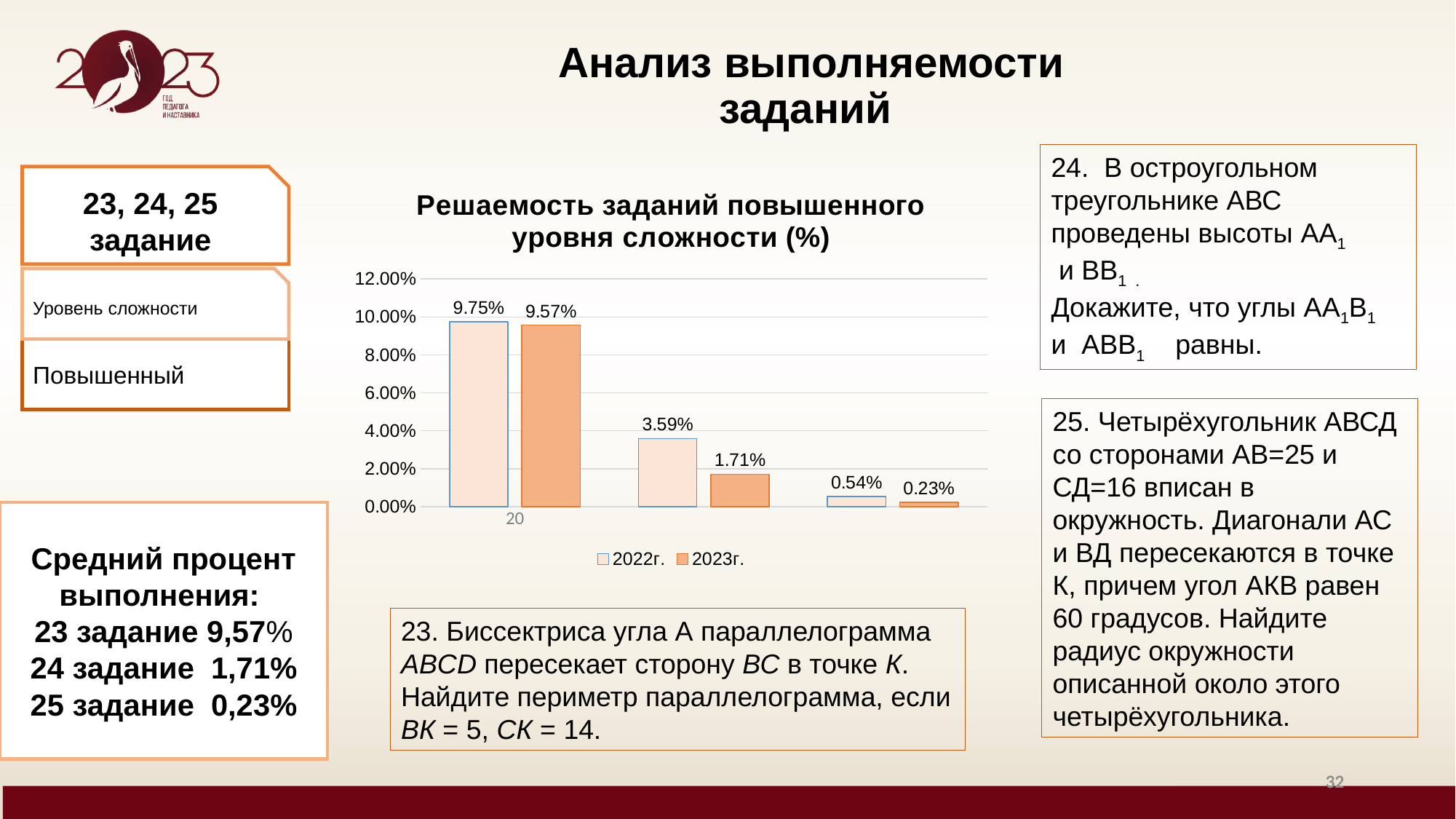
What kind of chart is shown on the slide? bar chart What is the value of the 2023г. bar in the second (middle) group? 1.71% How many groups of bars are plotted in the chart? 3 What is the value of the 2022г. bar in the third (rightmost) group? 0.54% In the middle group, which series has the larger value, 2022г. or 2023г.? 2022г. What is the title of the chart? Решаемость заданий повышенного уровня сложности (%) What is the highest value shown in the chart? 9.75% What are the two series named in the legend? 2022г. and 2023г. How many series does the chart legend list? 2 What is the value of the 2022г. bar in the first (leftmost) group? 9.75% What is the lowest value shown in the chart? 0.23% In the middle group, what is the difference between the 2022г. and 2023г. values? 1.88%